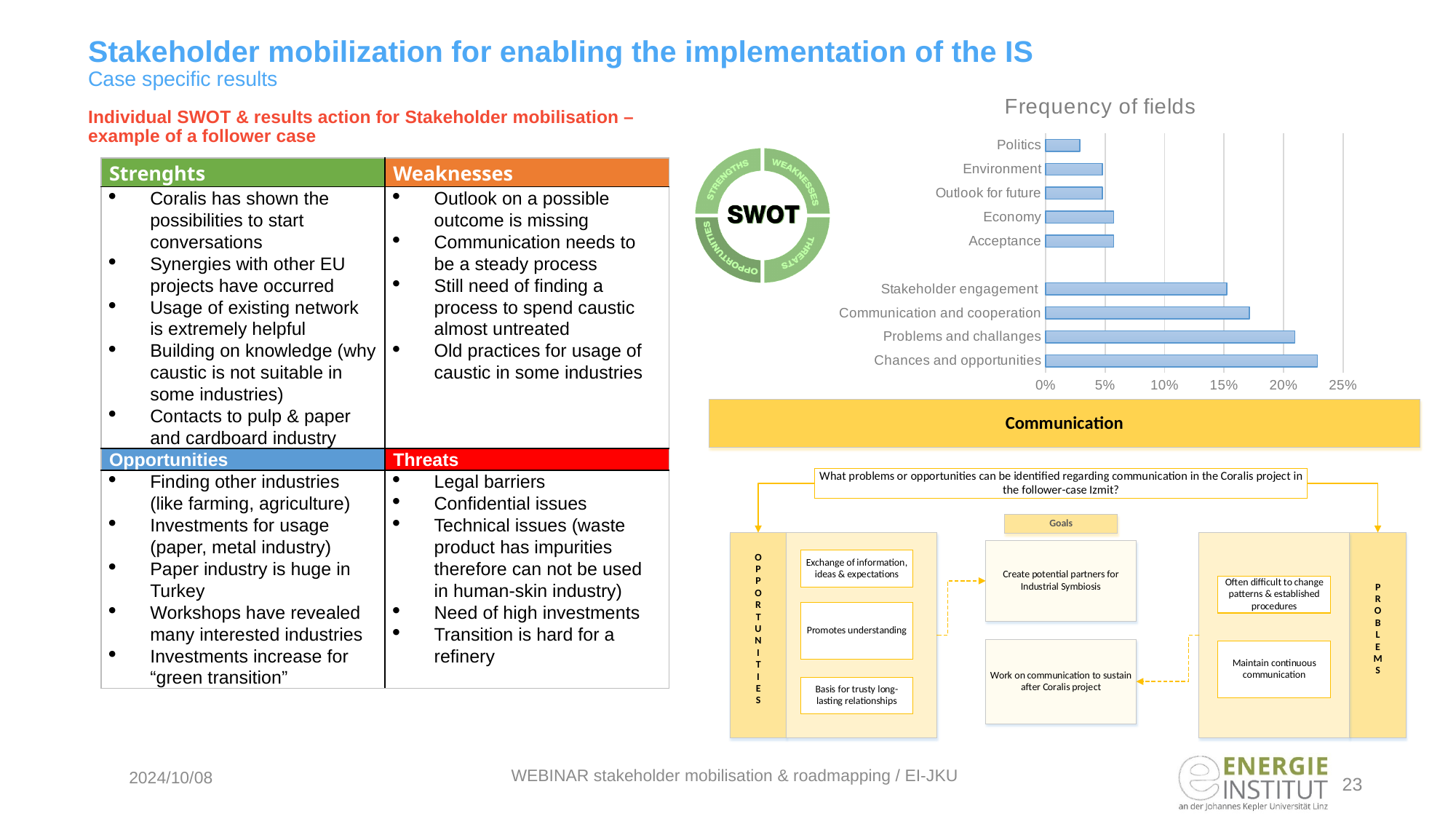
In the "Frequency of fields" chart, is the value for Acceptance greater or less than 10%? less What kind of chart is the "Frequency of fields" chart? bar chart In the "Frequency of fields" chart, is the value for Stakeholder engagement greater or less than 10%? greater What is the title of the chart on the slide? Frequency of fields How many categories are plotted in the "Frequency of fields" chart? 9 What is the highest value shown on the x axis of the "Frequency of fields" chart? 25% In the "Frequency of fields" chart, is the value for Politics greater or less than 5%? less In the "Frequency of fields" chart, which is larger: Problems and challenges or Stakeholder engagement? Problems and challenges In the "Frequency of fields" chart, which category has the lowest value? Politics In the "Frequency of fields" chart, which category has the highest value? Chances and opportunities